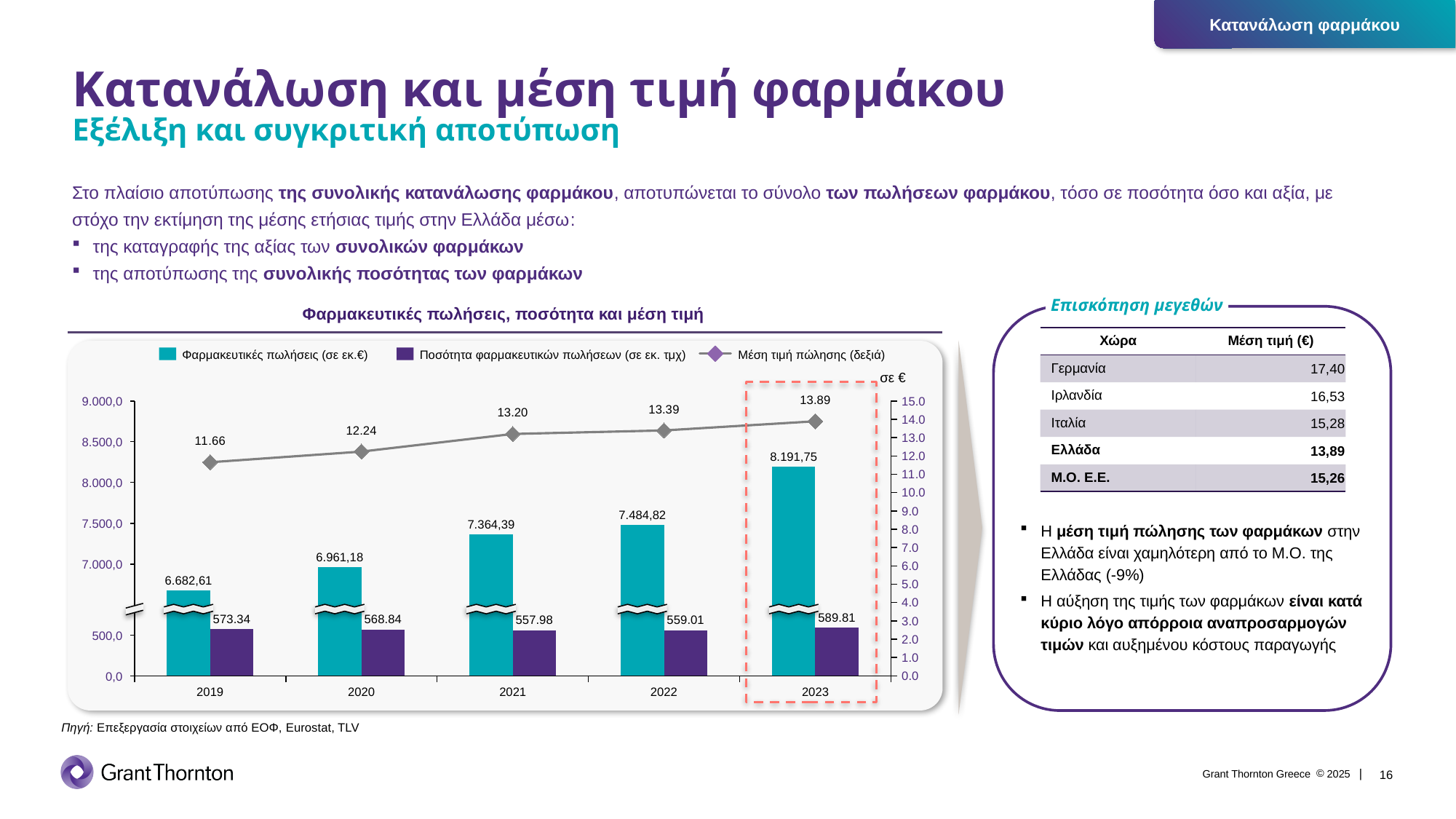
In which year is 'Φαρμακευτικές πωλήσεις (σε εκ.€)' highest? 2023 What is the difference in 'Μέση τιμή πώλησης' between 2023 and 2019? 2.23 How many years are shown on the x axis of the chart? 5 In which year is 'Ποσότητα φαρμακευτικών πωλήσεων (σε εκ. τμχ)' lowest? 2021 What is the difference in 'Ποσότητα φαρμακευτικών πωλήσεων (σε εκ. τμχ)' between 2023 and 2022? 30.80 What is the value of 'Φαρμακευτικές πωλήσεις (σε εκ.€)' for 2023? 8.191,75 How many series does the legend of the chart list? 3 What is the 'Μέση τιμή πώλησης' value for 2019? 11.66 Does 'Μέση τιμή πώλησης' rise or fall from 2019 to 2023? Rise What is the value of 'Ποσότητα φαρμακευτικών πωλήσεων (σε εκ. τμχ)' for 2021? 557.98 Which is larger: 'Ποσότητα φαρμακευτικών πωλήσεων' in 2019 or in 2020? 2019 What type of chart is shown under the title 'Φαρμακευτικές πωλήσεις, ποσότητα και μέση τιμή'? Combined bar and line chart